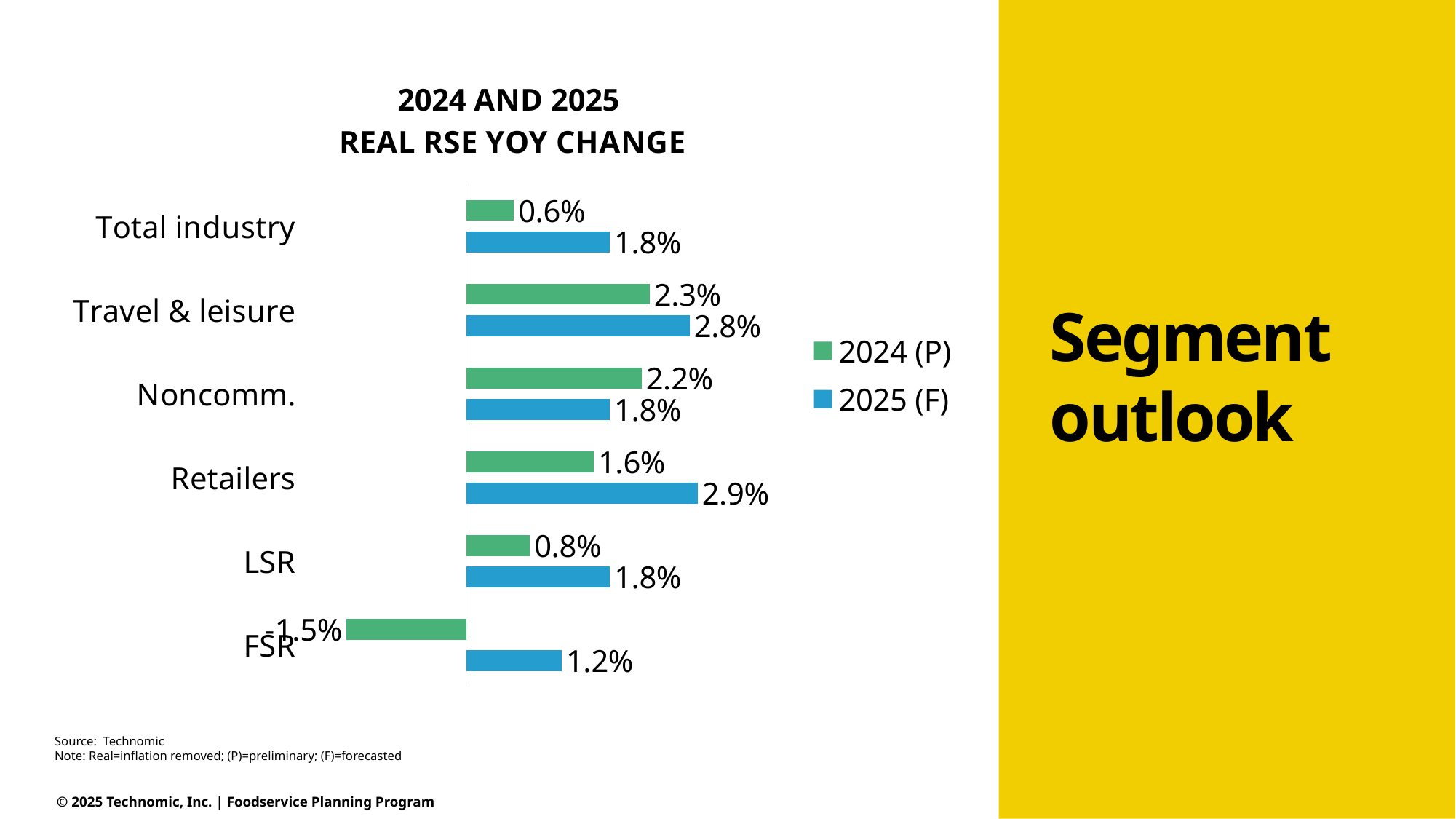
What is the title of the chart? 2024 AND 2025 REAL RSE YOY CHANGE What is the 2025 (F) value for Retailers? 2.9% What kind of chart is shown on the slide? Bar chart For Noncomm., which is larger: the 2024 (P) value or the 2025 (F) value? 2024 (P) What is the 2024 (P) value for FSR? -1.5% How many series does the legend list? 2 What is the 2024 (P) value for Travel & leisure? 2.3% How many categories are shown on the chart? 6 What is the 2025 (F) value for Total industry? 1.8% What is the difference between the 2025 (F) and 2024 (P) values for Retailers? 1.3% Which category has the highest 2025 (F) value? Retailers Which category has the lowest 2024 (P) value? FSR